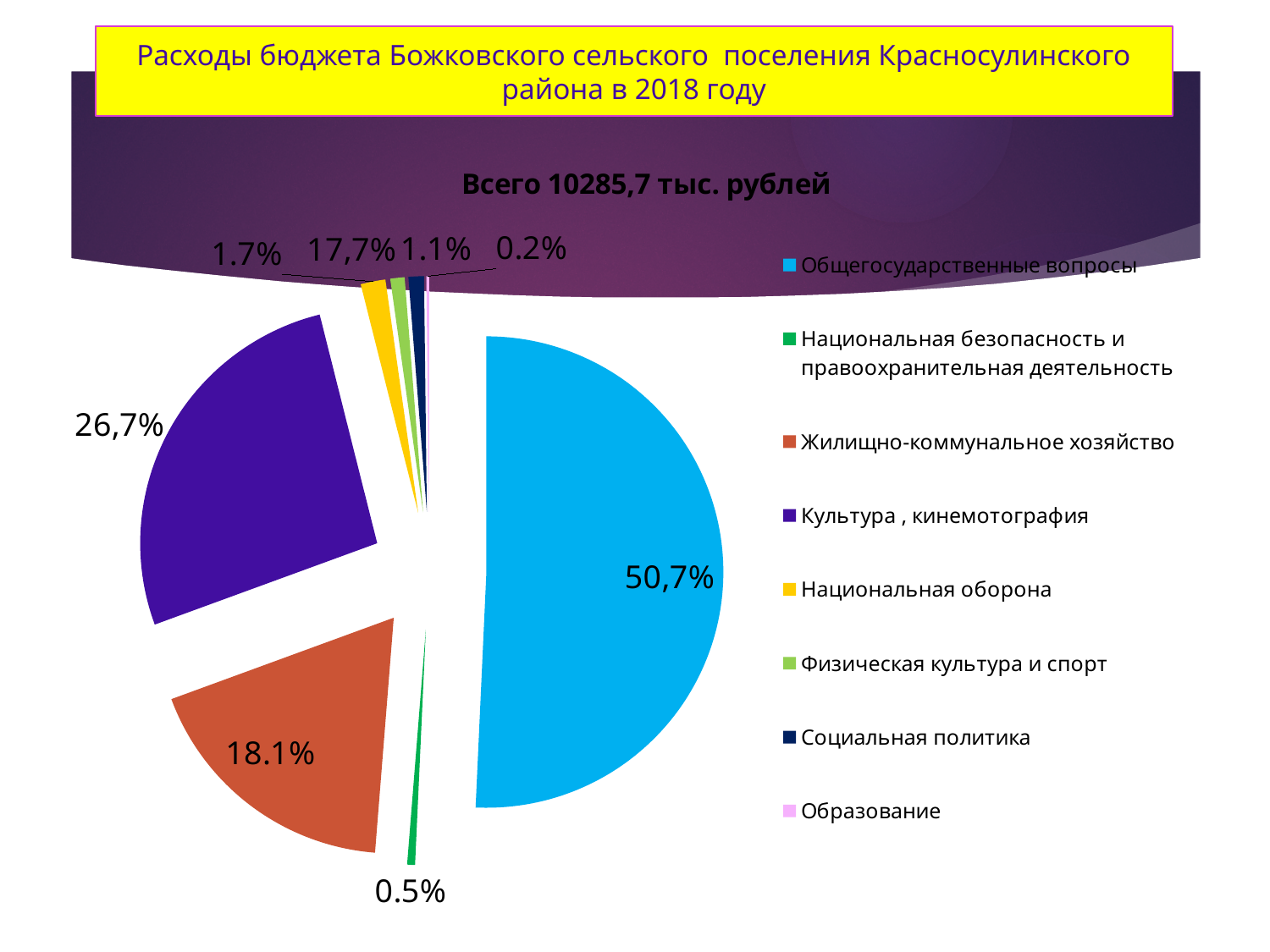
By how many percentage points does the share of Общегосударственные вопросы exceed that of Культура, кинемотография? 24,0 What total expenditure amount is stated above the chart? 10285,7 тыс. рублей What share of the budget expenditure goes to Общегосударственные вопросы? 50,7% What share of the budget expenditure goes to Культура, кинемотография? 26,7% What share of the budget expenditure goes to Жилищно-коммунальное хозяйство? 18.1% How many categories does the legend list? 8 What kind of chart is shown on the slide? pie chart What share of the budget expenditure goes to Образование? 0.2% Which category has the largest share of the pie? Общегосударственные вопросы Which has a larger share: Культура, кинемотография or Жилищно-коммунальное хозяйство? Культура, кинемотография What share of the budget expenditure goes to Национальная безопасность и правоохранительная деятельность? 0.5% Which category has the smallest share of the pie? Образование